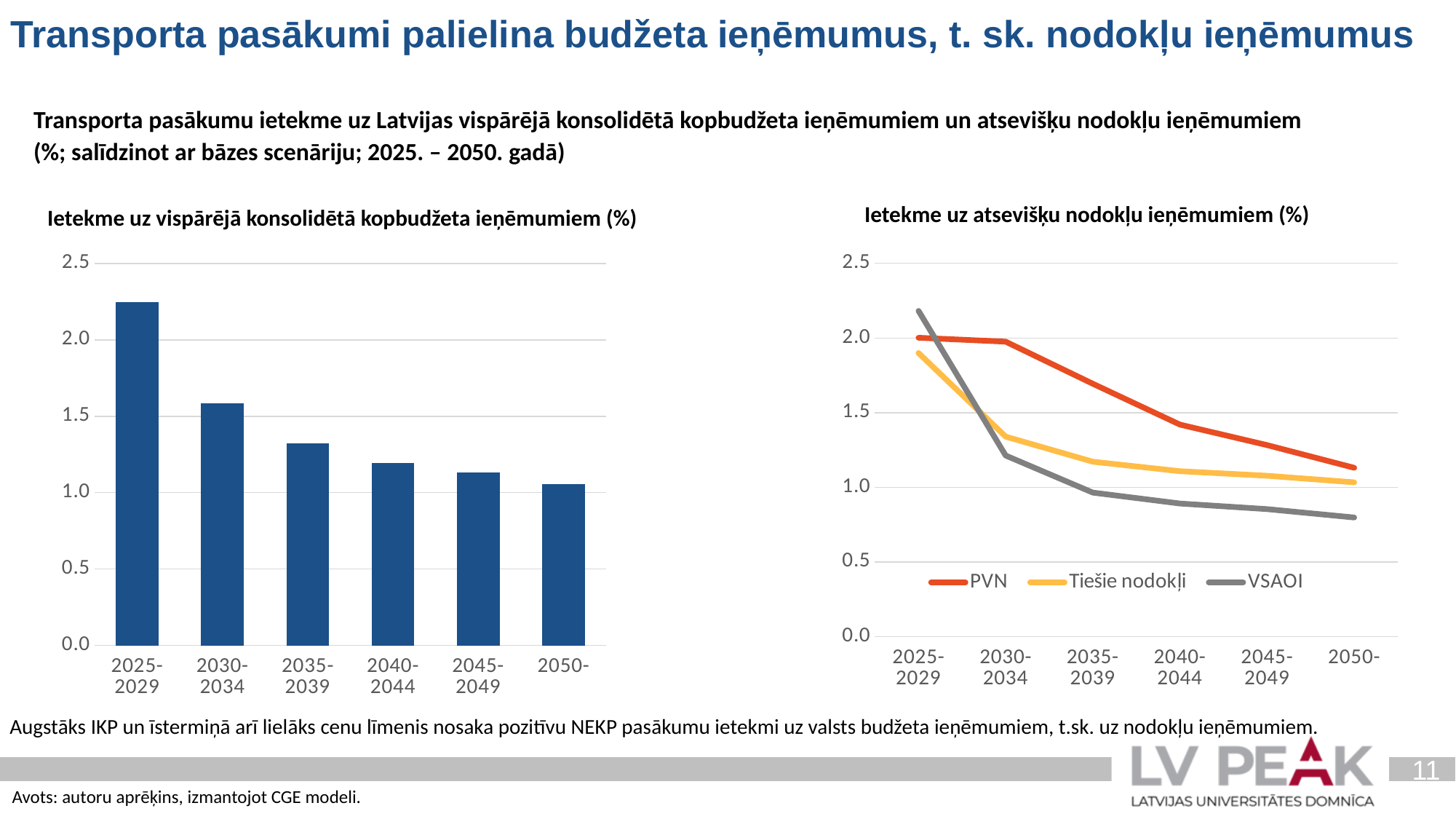
In the chart titled "Ietekme uz atsevišķu nodokļu ieņēmumiem (%)", is the VSAOI value for 2050- greater or less than 1.0? less In the chart titled "Ietekme uz atsevišķu nodokļu ieņēmumiem (%)", which series has the highest value in 2025-2029? VSAOI In the chart titled "Ietekme uz atsevišķu nodokļu ieņēmumiem (%)", how many series does the legend list? 3 In the chart titled "Ietekme uz vispārējā konsolidētā kopbudžeta ieņēmumiem (%)", is the value for 2025-2029 greater or less than 2.0? greater In the chart titled "Ietekme uz vispārējā konsolidētā kopbudžeta ieņēmumiem (%)", is the value for 2035-2039 greater or less than 1.5? less In the chart titled "Ietekme uz vispārējā konsolidētā kopbudžeta ieņēmumiem (%)", which period has the highest bar? 2025-2029 In the chart titled "Ietekme uz vispārējā konsolidētā kopbudžeta ieņēmumiem (%)", do the values rise or fall from 2025-2029 to 2050-? fall In the chart titled "Ietekme uz atsevišķu nodokļu ieņēmumiem (%)", which is larger in 2040-2044, PVN or VSAOI? PVN In the chart titled "Ietekme uz atsevišķu nodokļu ieņēmumiem (%)", what kind of chart is shown? line chart In the chart titled "Ietekme uz vispārējā konsolidētā kopbudžeta ieņēmumiem (%)", which period has the lowest bar? 2050- In the chart titled "Ietekme uz vispārējā konsolidētā kopbudžeta ieņēmumiem (%)", what kind of chart is shown? bar chart In the chart titled "Ietekme uz vispārējā konsolidētā kopbudžeta ieņēmumiem (%)", how many period categories are shown on the x axis? 6